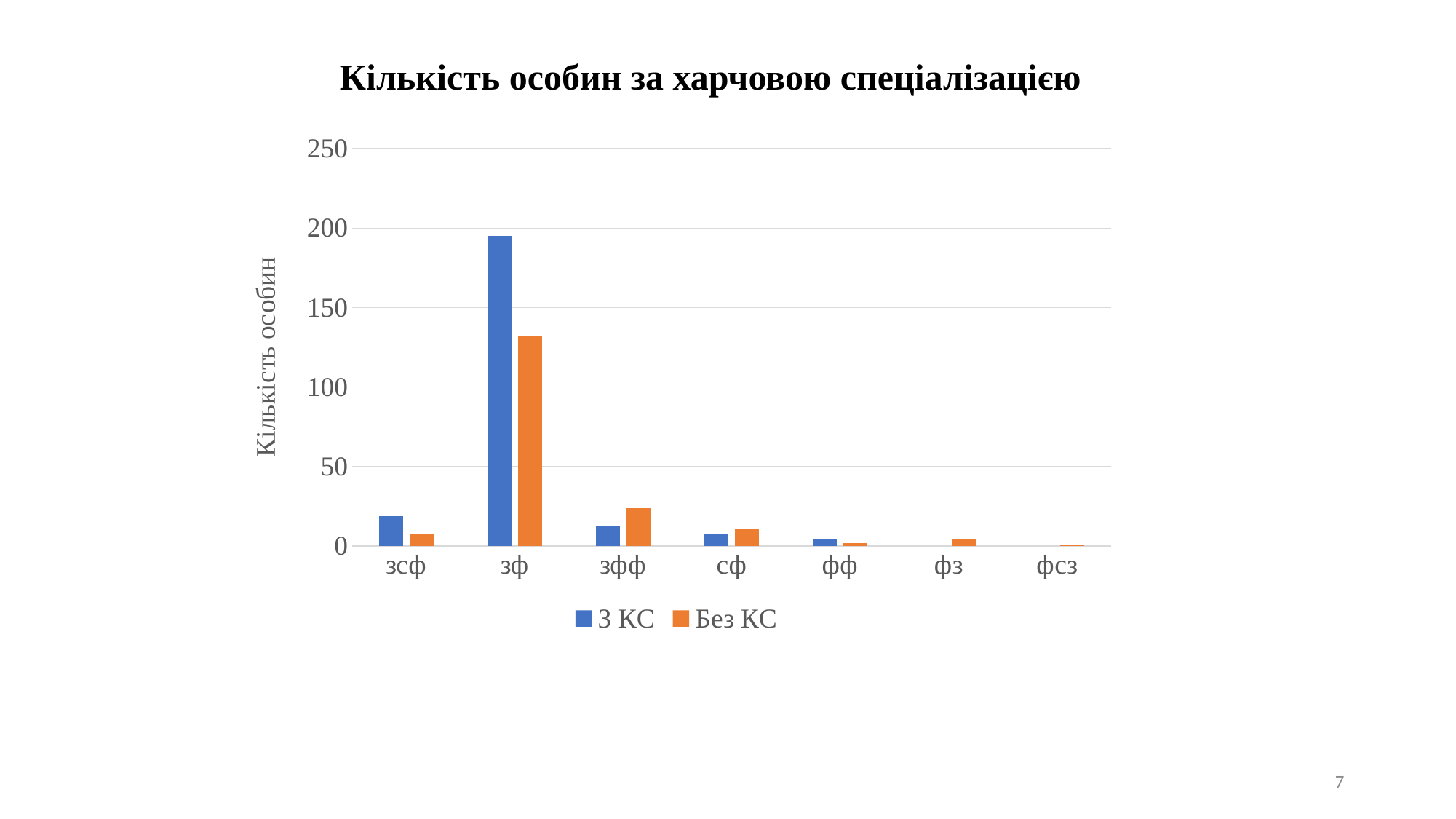
Is the value for З КС in category зсф greater or less than 50? less What is the title of the chart? Кількість особин за харчовою спеціалізацією In category зф, which series has the larger value, З КС or Без КС? З КС In category зфф, which series has the larger value, З КС or Без КС? Без КС How many series does the legend list? 2 Which category has the highest value for the Без КС series? зф Is the value for З КС in category зф greater or less than 150? greater How many categories are shown on the x axis? 7 What is the label of the y axis? Кількість особин What kind of chart is shown on the slide? bar chart Which category has the highest value for the З КС series? зф Is the value for Без КС in category зф greater or less than 150? less